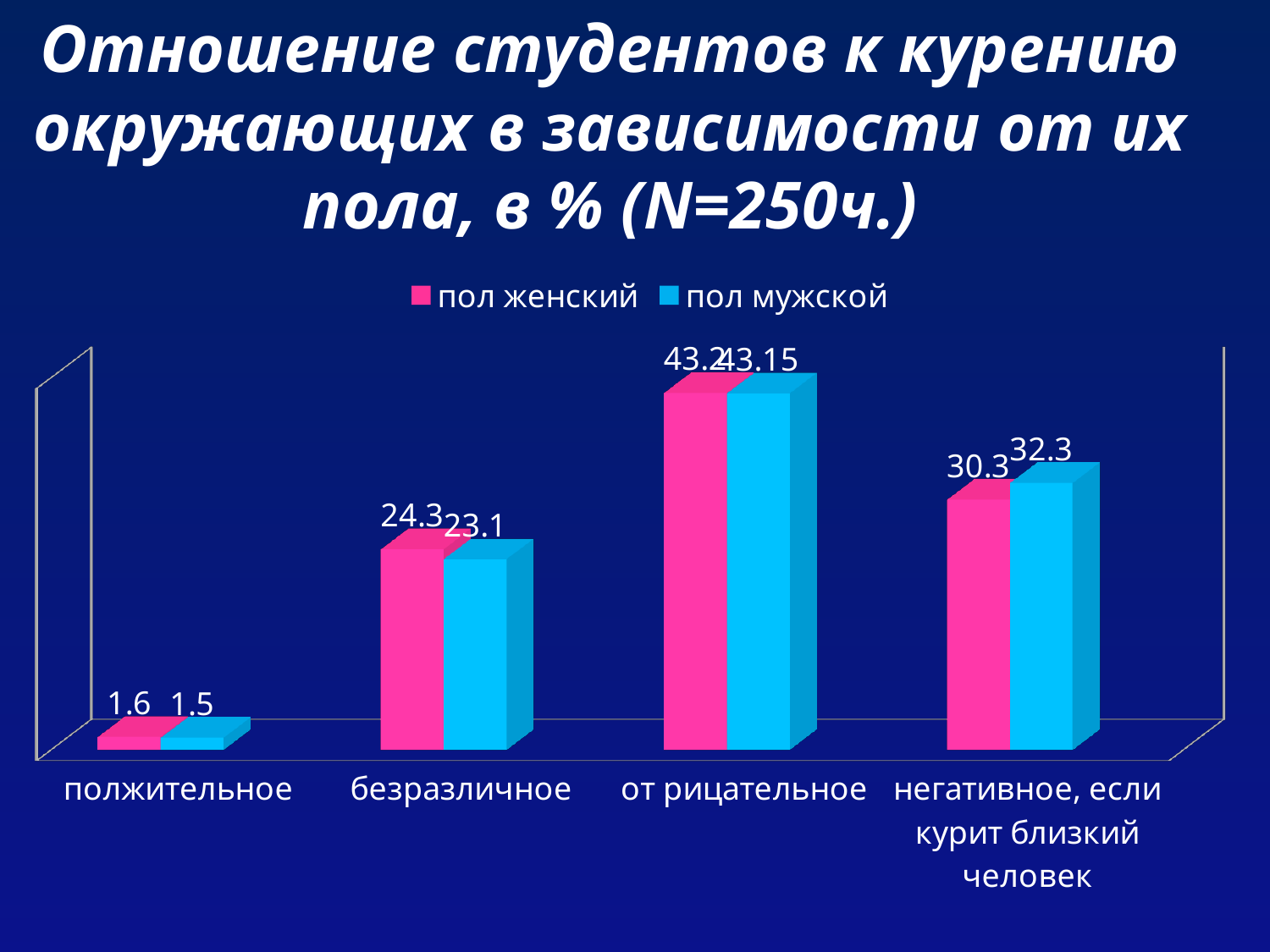
How many categories are shown on the x axis? 4 What is the value for пол мужской in the безразличное category? 23.1 What is the value for пол мужской in the category негативное, если курит близкий человек? 32.3 What is the value for пол женский in the безразличное category? 24.3 Which category has the highest value for пол мужской? от рицательное What is the value for пол женский in the category негативное, если курит близкий человек? 30.3 In the category негативное, если курит близкий человек, what is the difference between пол мужской and пол женский? 2 In the безразличное category, which series has the larger value, пол женский or пол мужской? пол женский Which category has the lowest value for пол женский? полжительное What is the value for пол мужской in the полжительное category? 1.5 What is the value for пол женский in the полжительное category? 1.6 How many series does the legend list? 2